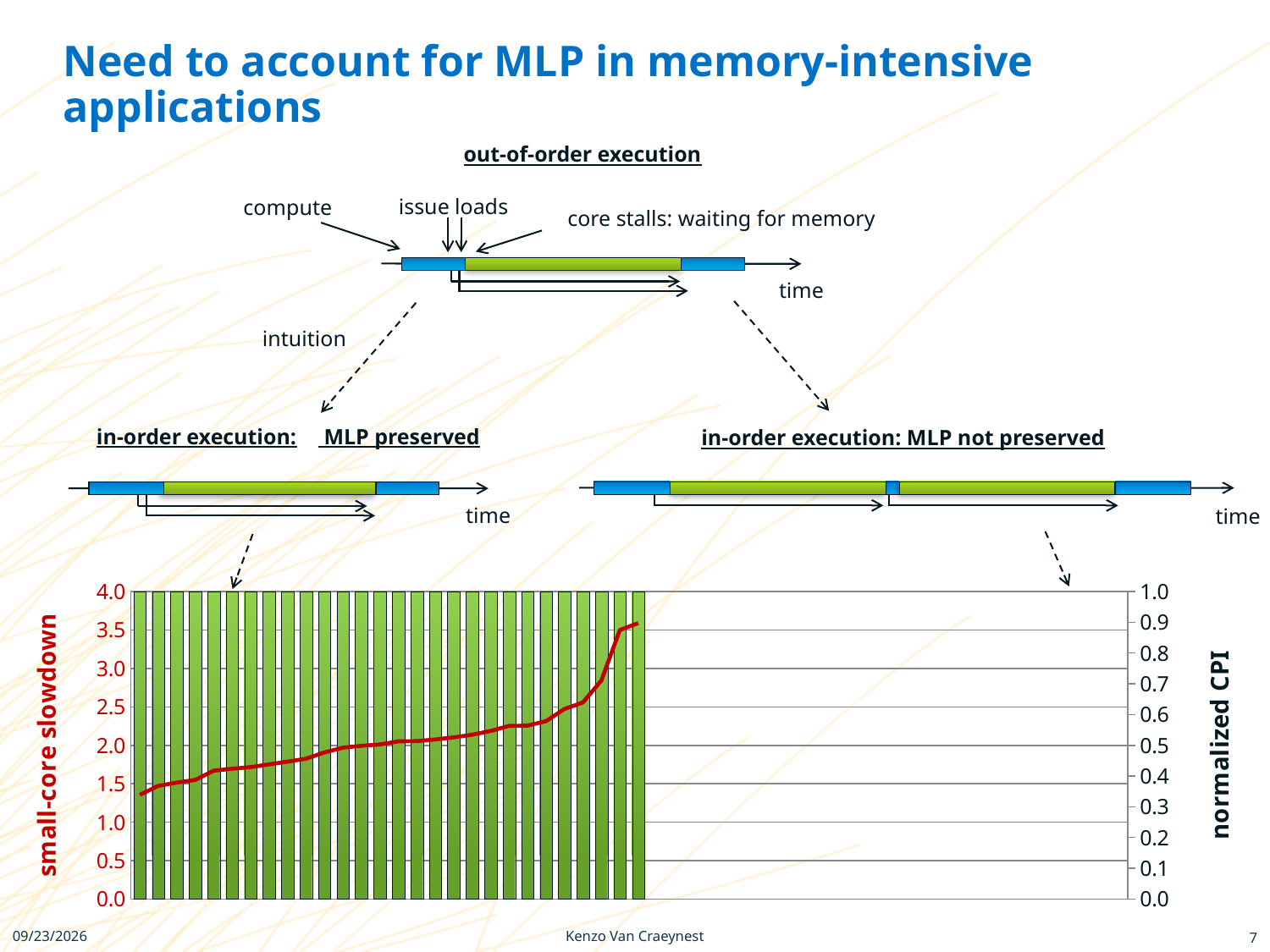
Is the value of the rightmost point of the red line greater or less than 3.0 on the small-core slowdown axis? greater Which is higher on the red line: the leftmost point or the rightmost point? rightmost point Does the red line rise or fall from left to right across the chart? rise Is the value of the leftmost point of the red line greater or less than 2.0 on the small-core slowdown axis? less What is the title of the left vertical axis of the chart? small-core slowdown What value on the normalized CPI axis do the green bars reach? 1.0 Is the highest point of the red line greater or less than 4.0 on the small-core slowdown axis? less What is the title of the right vertical axis of the chart? normalized CPI What kind of chart is shown at the bottom of the slide? bar chart with a line